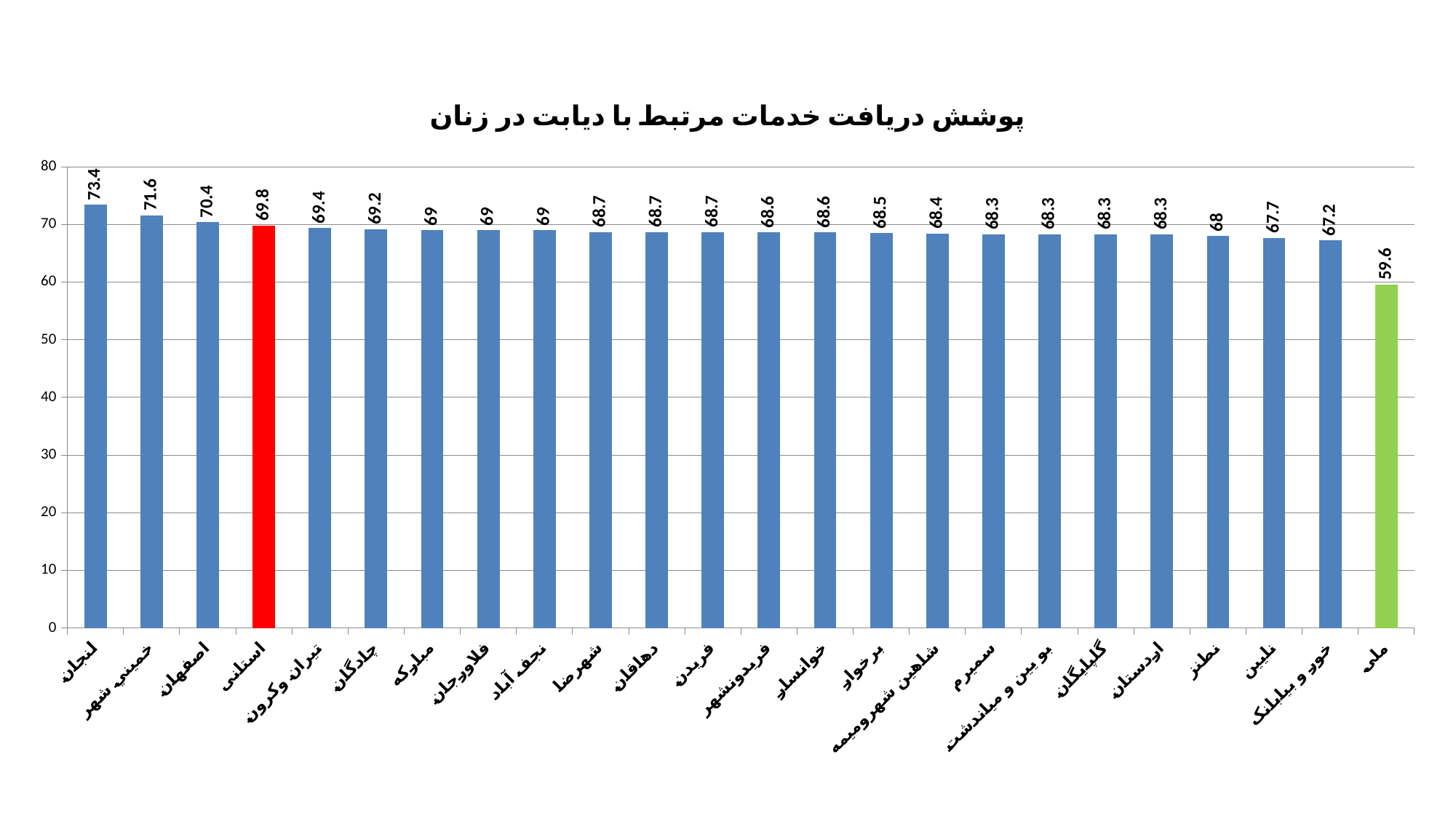
What is the value for لنجان? 73.4 What is the value for استانی? 69.8 How many bars are shown in the chart? 24 What is the value for خور و بیابانک? 67.2 What kind of chart is this? bar chart What is the value for ملی? 59.6 What is the difference between the values for استانی and ملی? 10.2 Which category has the highest value? لنجان What is the difference between the values for لنجان and ملی? 13.8 Which category has the lowest value? ملی Is the value for ملی greater or less than 60? less Which is larger, the value for خمینی شهر or the value for اصفهان? خمینی شهر